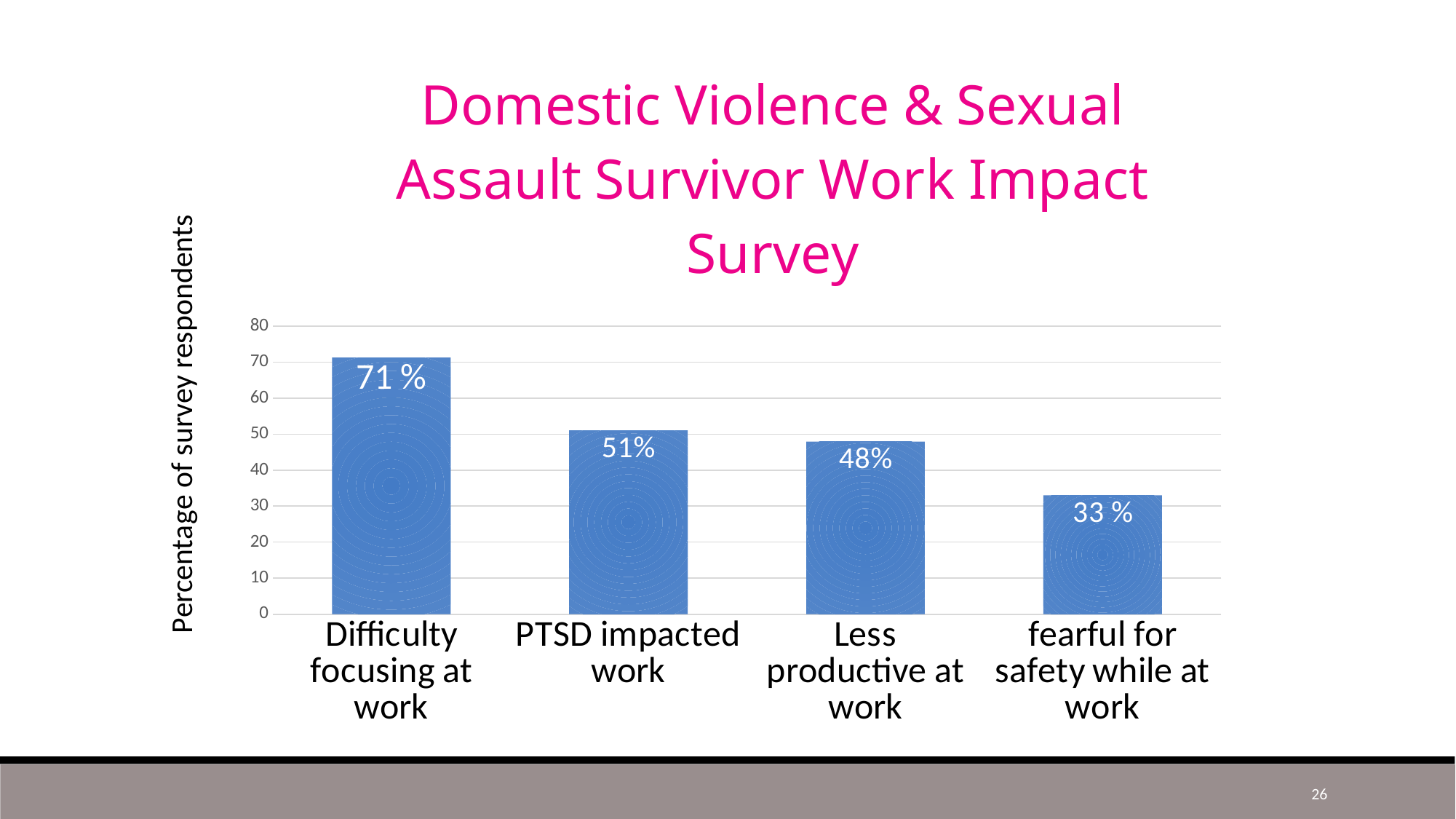
Which category has the lowest percentage of survey respondents? fearful for safety while at work What percentage of survey respondents reported being less productive at work? 48% What is the label of the vertical axis? Percentage of survey respondents Which category has the highest percentage of survey respondents? Difficulty focusing at work Is the value for 'Less productive at work' greater or less than 40? greater What percentage of survey respondents reported difficulty focusing at work? 71 % What percentage of survey respondents reported that PTSD impacted work? 51% What is the difference in percentage points between 'Difficulty focusing at work' and 'fearful for safety while at work'? 38 How many categories are shown in the chart? 4 Which is larger: the value for 'PTSD impacted work' or 'Less productive at work'? PTSD impacted work What kind of chart is shown on the slide? Bar chart What percentage of survey respondents reported being fearful for safety while at work? 33 %